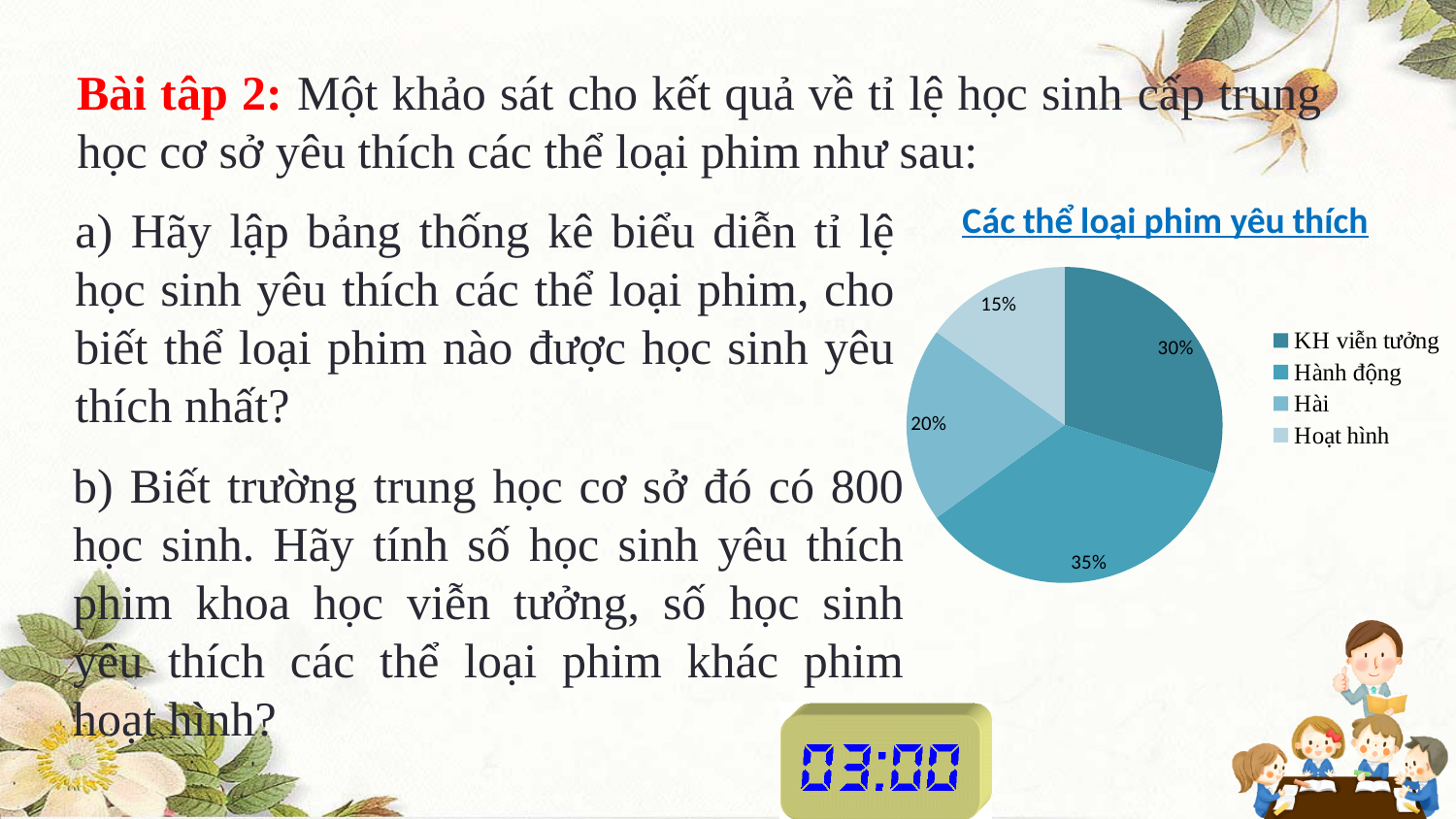
How many categories does the legend of the pie chart list? 4 What is the difference in percentage points between Hành động and Hoạt hình? 20 What percentage of students prefer Hoạt hình films? 15% What percentage of students prefer Hài films? 20% What percentage of students prefer KH viễn tưởng films? 30% Which has a larger share, KH viễn tưởng or Hài? KH viễn tưởng What kind of chart is shown on the slide? pie chart What percentage of students prefer Hành động films? 35% Which legend entry is listed first in the pie chart's legend? KH viễn tưởng What is the title of the chart? Các thể loại phim yêu thích Which film genre has the smallest share in the pie chart? Hoạt hình Which film genre has the largest share in the pie chart? Hành động